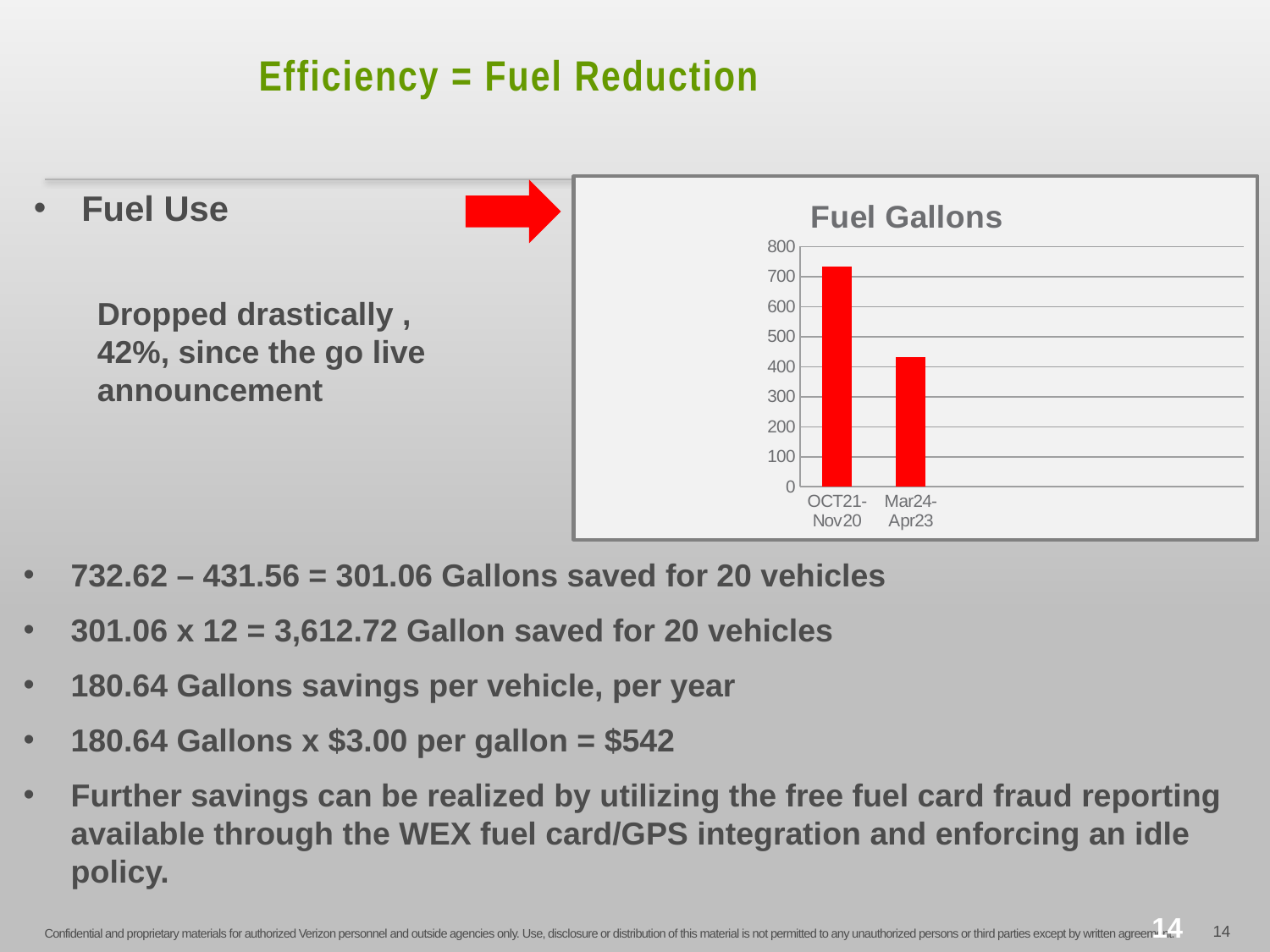
Is the value for OCT21-Nov20 greater or less than 700? greater Do the values rise or fall from OCT21-Nov20 to Mar24-Apr23? fall What colour are the bars in the Fuel Gallons chart? red Which is larger in the Fuel Gallons chart, OCT21-Nov20 or Mar24-Apr23? OCT21-Nov20 Which period has the lowest value in the Fuel Gallons chart? Mar24-Apr23 Is the value for Mar24-Apr23 greater or less than 500? less How many bars are plotted in the Fuel Gallons chart? 2 What is the highest tick value shown on the vertical axis of the Fuel Gallons chart? 800 What is the title of the chart? Fuel Gallons What kind of chart is shown on the slide? bar chart Which period has the highest value in the Fuel Gallons chart? OCT21-Nov20 Is the value for Mar24-Apr23 greater or less than 400? greater